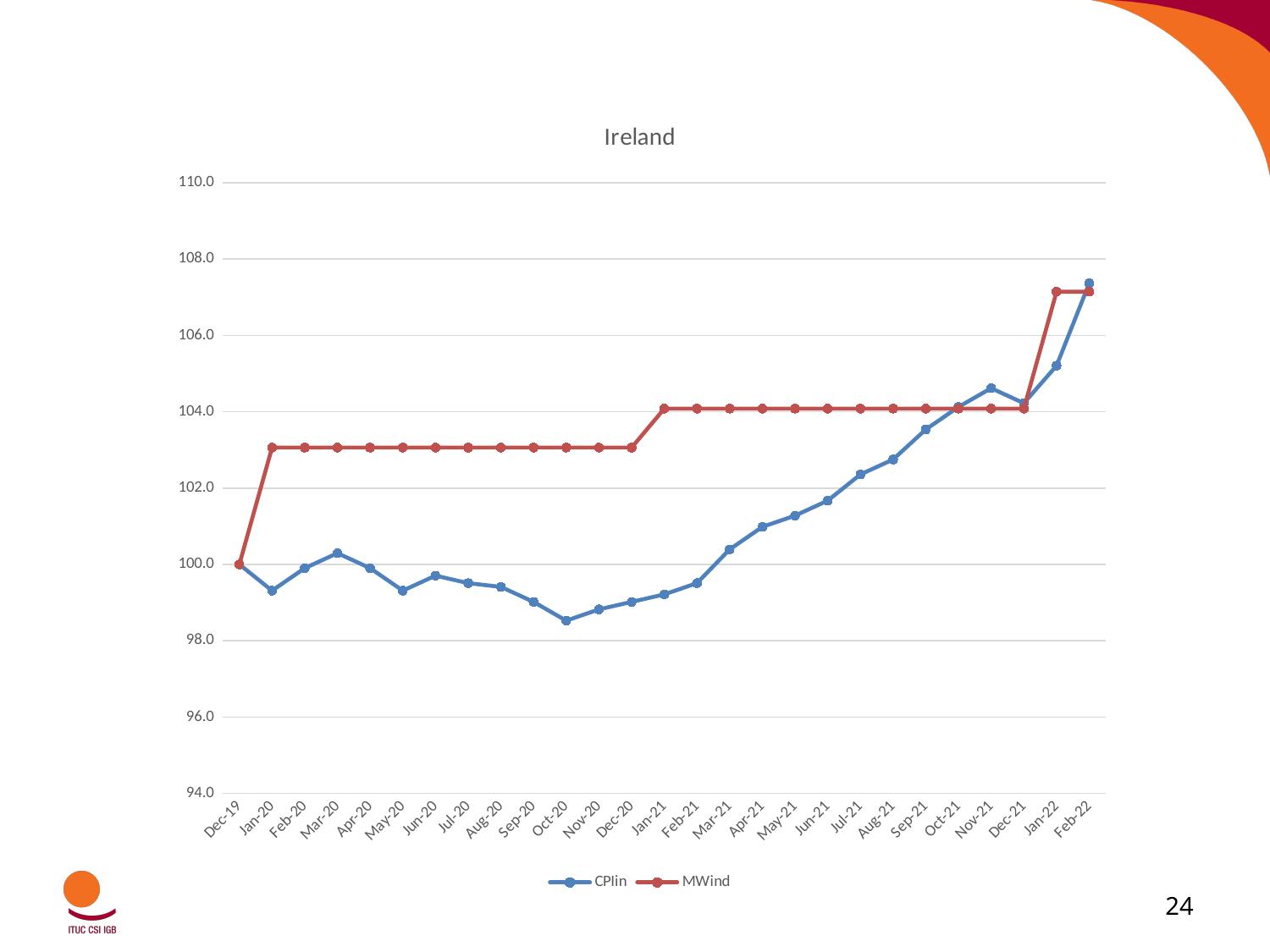
What is the title of the chart? Ireland Which colour is used for the MWind series? red In Jun-20, which series has the higher value, CPIin or MWind? MWind Is the value for MWind in Jan-22 greater or less than 106.0? greater Is the value for CPIin in Oct-20 greater or less than 100.0? less How many months are plotted along the x axis? 27 What kind of chart is shown on the slide? line chart How many series does the legend list? 2 In which month does the CPIin series reach its highest value? Feb-22 What is the value of CPIin in Dec-19? 100.0 Is the value for MWind in Feb-20 greater or less than 102.0? greater In which month does the CPIin series reach its lowest value? Oct-20